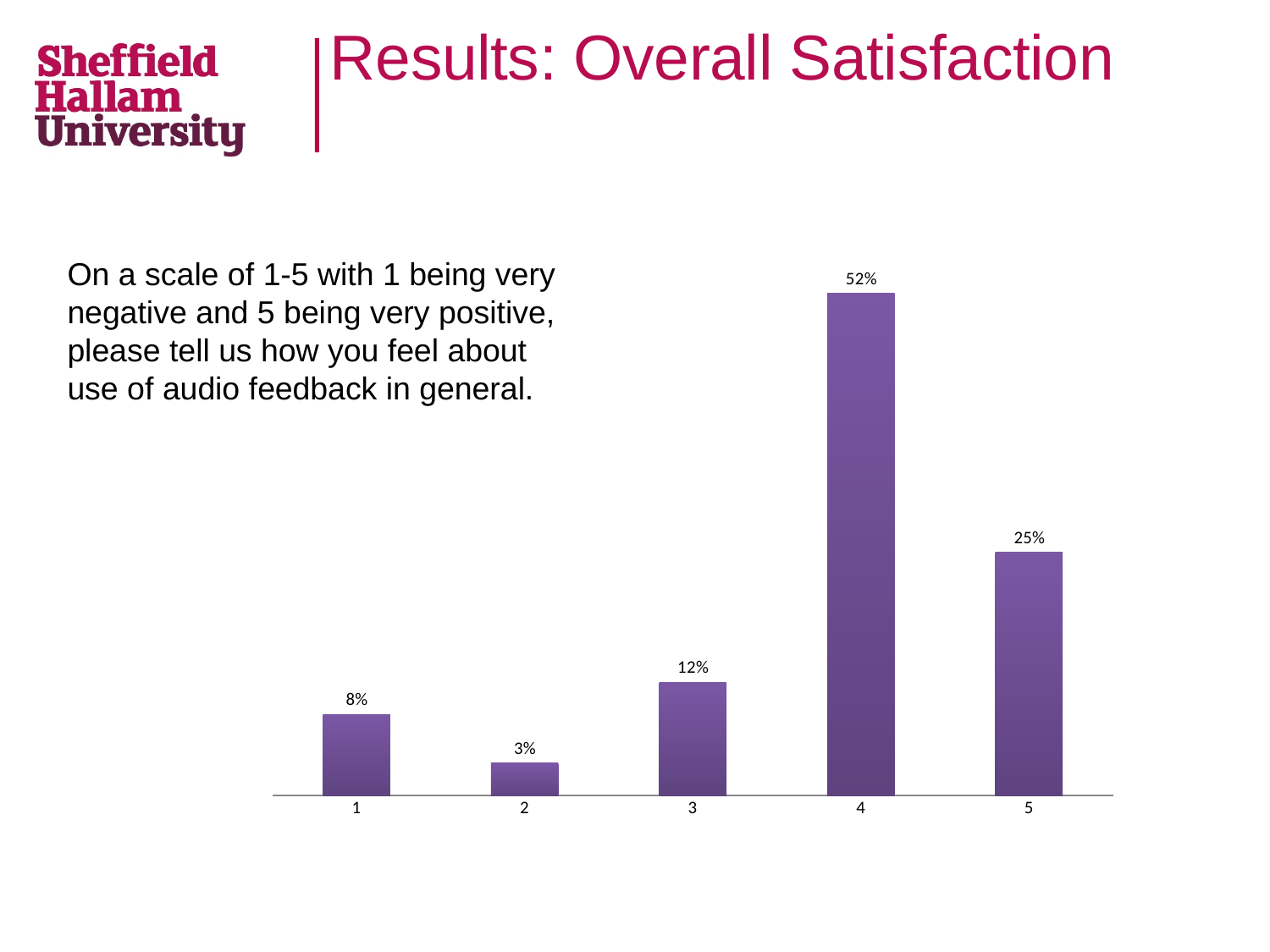
What percentage of respondents gave a rating of 3? 12% What is the difference in percentage points between rating 1 and rating 2? 5% Which rating received the highest percentage of responses? 4 What is the combined percentage of respondents who gave a rating of 4 or 5? 77% What is the difference in percentage points between rating 4 and rating 5? 27% Which rating received the lowest percentage of responses? 2 How many rating categories are shown on the x axis of the chart? 5 What percentage of respondents gave a rating of 1? 8% What type of chart is shown on the slide? Bar chart What percentage of respondents gave a rating of 5? 25% What percentage of respondents gave a rating of 4? 52% Which has a larger percentage, rating 3 or rating 1? Rating 3